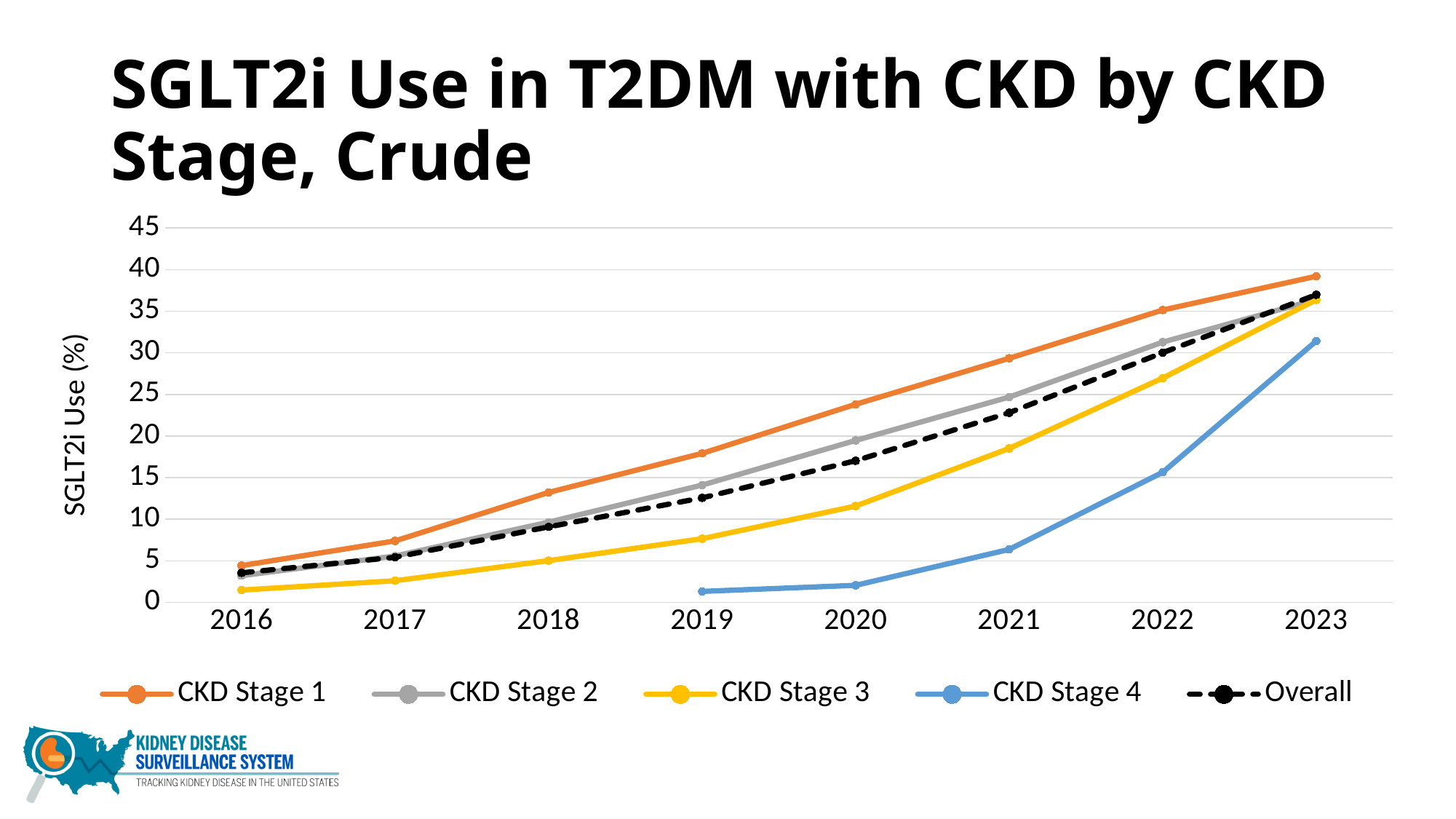
How many years are shown on the x axis? 8 Which series has the highest value in 2023? CKD Stage 1 What kind of chart is shown on the slide? line chart Is the value for CKD Stage 1 in 2023 greater or less than 35? greater Is the value for CKD Stage 3 in 2020 greater or less than 15? less Which series has the lowest value in 2023? CKD Stage 4 Which series is drawn with a dashed line? Overall How many series does the legend list? 5 Is the value for CKD Stage 4 in 2021 greater or less than 10? less In 2020, which is larger: the value for CKD Stage 1 or the value for CKD Stage 3? CKD Stage 1 Does the CKD Stage 1 line rise or fall from 2016 to 2023? rise Which series has the lowest value in 2016? CKD Stage 3